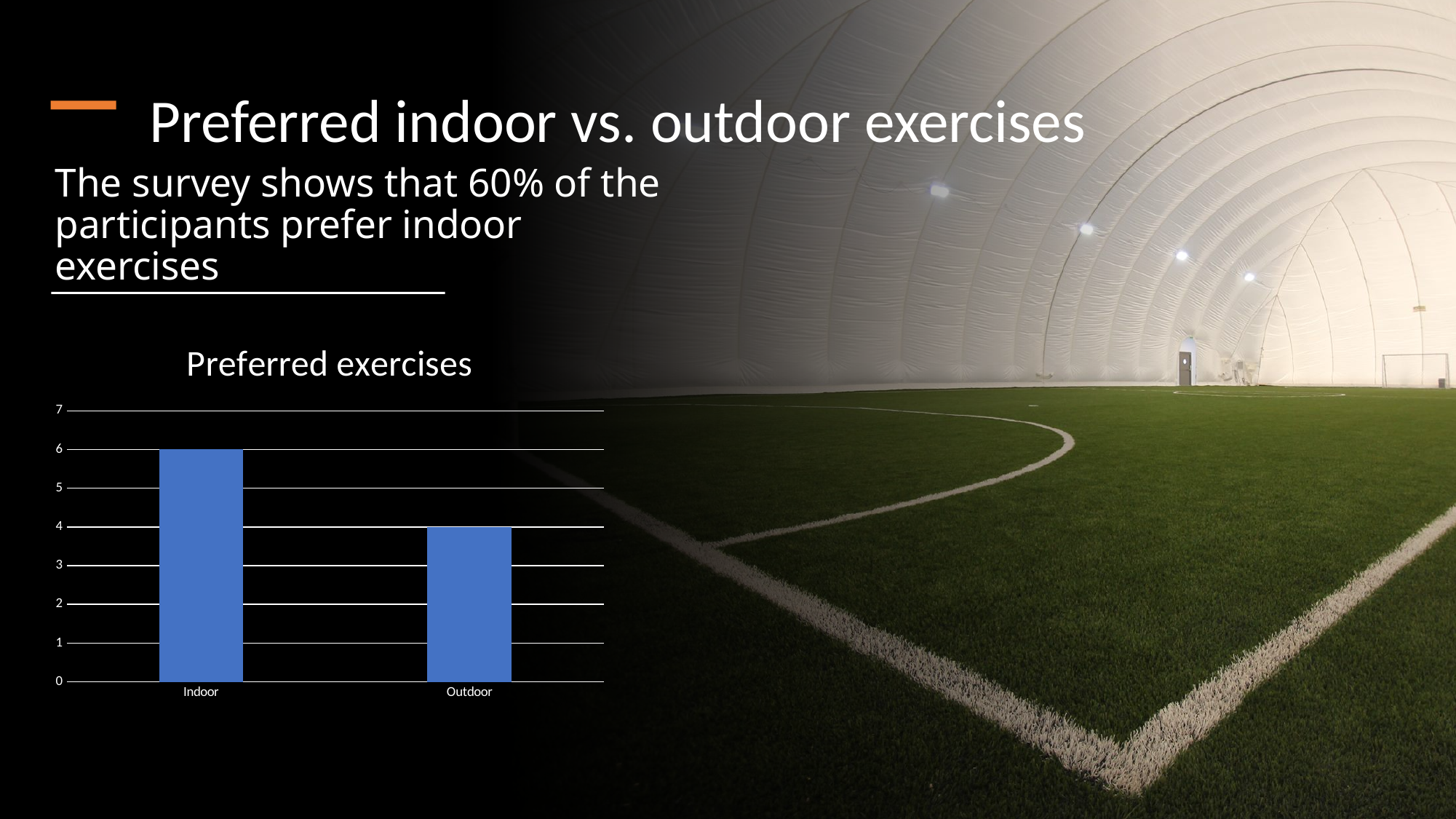
Which is larger in the Preferred exercises chart, Indoor or Outdoor? Indoor Is the value for Indoor greater or less than 5 in the Preferred exercises chart? greater What is the highest value shown on the vertical axis of the Preferred exercises chart? 7 How many categories are shown in the Preferred exercises chart? 2 Is the value for Outdoor greater or less than 5 in the Preferred exercises chart? less Which category has the lowest value in the Preferred exercises chart? Outdoor Which category has the highest value in the Preferred exercises chart? Indoor What is the title of the chart on the slide? Preferred exercises What is the value for Indoor in the Preferred exercises chart? 6 What is the value for Outdoor in the Preferred exercises chart? 4 What is the difference between the Indoor and Outdoor values in the Preferred exercises chart? 2 What kind of chart is the Preferred exercises chart? bar chart